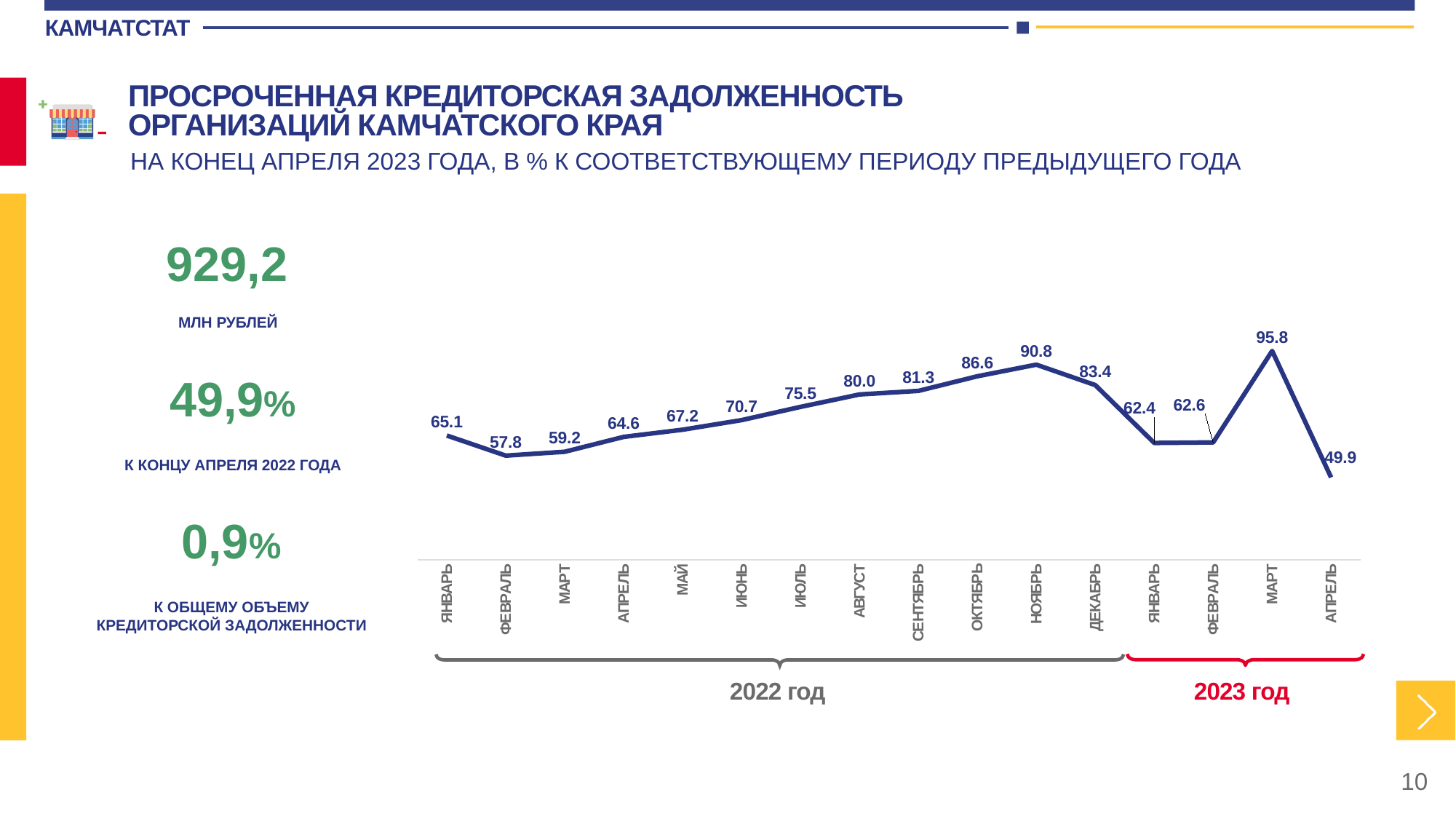
What is the difference between the values for November 2022 and December 2022? 7.4 How many data points are plotted on the line chart? 16 Does the line rise or fall from February 2022 to November 2022? rise Which month has the highest value on the chart? МАРТ 2023 (March 2023) What is the value for November 2022 (НОЯБРЬ, 2022 год)? 90.8 What is the value for January 2022 (ЯНВАРЬ, 2022 год)? 65.1 What is the value for March 2023 (МАРТ, 2023 год)? 95.8 Which month has the lowest value on the chart? АПРЕЛЬ 2023 (April 2023) Which is larger, the value for December 2022 or the value for January 2023? December 2022 (83.4) What is the value for April 2023 (АПРЕЛЬ, 2023 год)? 49.9 What kind of chart is shown on the slide? line chart What is the difference between the values for March 2023 and April 2023? 45.9